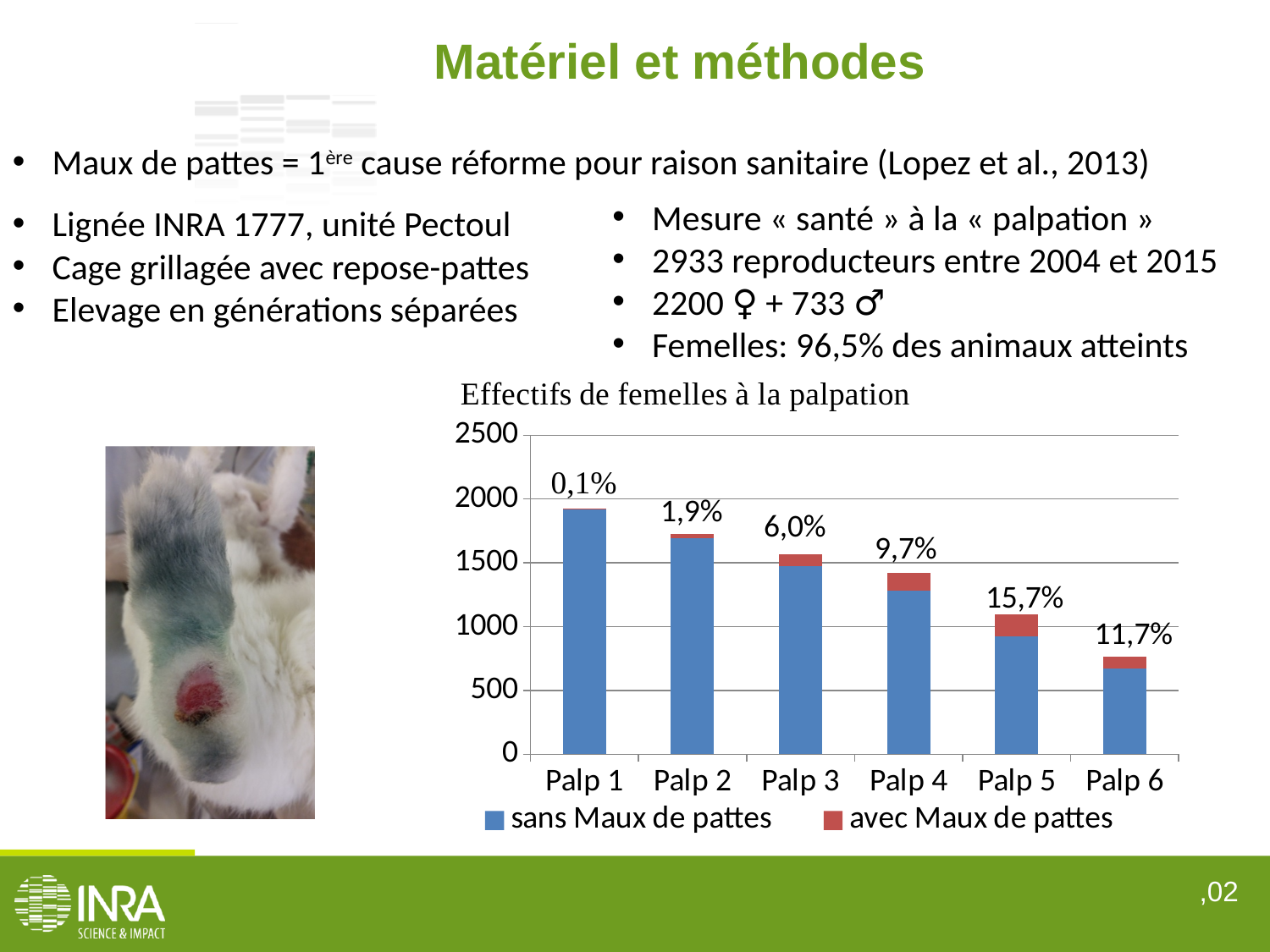
What percentage label is shown above the bar for Palp 5? 15,7% What percentage label is shown above the bar for Palp 1? 0,1% What is the title of the chart? Effectifs de femelles à la palpation Which palpation has the shortest total bar? Palp 6 How many categories (palpations) are shown on the x axis of the chart? 6 Which palpation has the tallest total bar? Palp 1 What percentage label is shown above the bar for Palp 3? 6,0% How many series does the chart legend list? 2 What kind of chart is shown on the slide? Stacked bar chart Is the total bar for Palp 6 greater or less than 1000? less Is the total bar for Palp 1 greater or less than 1500? greater Do the total bar heights rise or fall from Palp 1 to Palp 6? fall